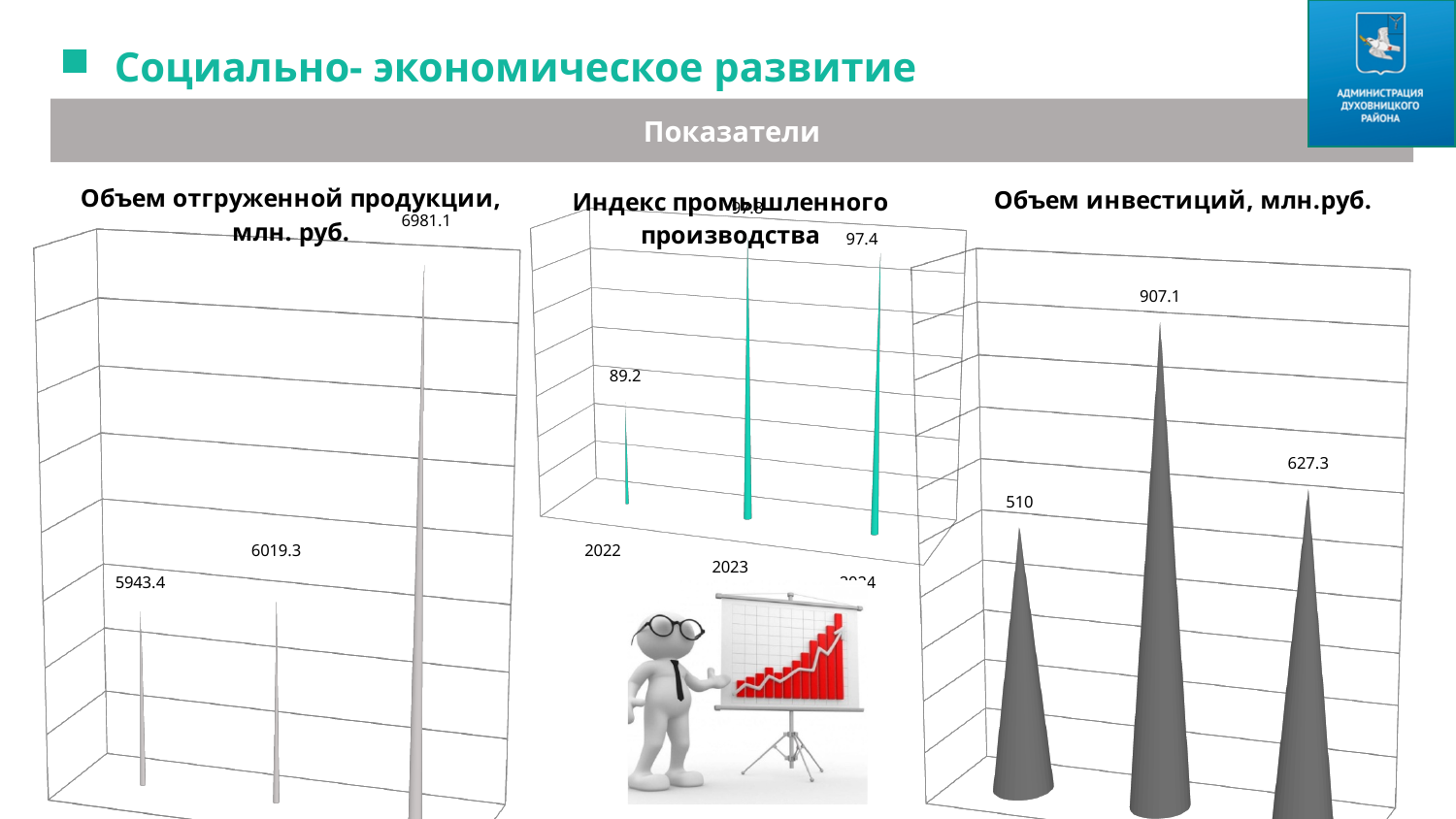
On the chart 'Объем отгруженной продукции, млн. руб.', what is the highest value shown? 6981.1 On the chart 'Индекс промышленного производства', what is the value for 2022? 89.2 On the chart 'Объем отгруженной продукции, млн. руб.', what is the difference between the highest value (6981.1) and the lowest value (5943.4)? 1037.7 On the chart 'Объем инвестиций, млн.руб.', what is the highest value shown? 907.1 On the chart 'Объем отгруженной продукции, млн. руб.', what is the lowest value shown? 5943.4 What kind of chart is 'Объем инвестиций, млн.руб.'? Bar chart On the chart 'Объем инвестиций, млн.руб.', what is the lowest value shown? 510 On the chart 'Индекс промышленного производства', what is the difference between the 2024 value and the 2022 value? 8.2 On the chart 'Индекс промышленного производства', which is larger, the value for 2022 or the value for 2024? 2024 On the chart 'Объем инвестиций, млн.руб.', what is the difference between the highest value (907.1) and the lowest value (510)? 397.1 On the chart 'Объем отгруженной продукции, млн. руб.', how many bars are plotted? 3 On the chart 'Индекс промышленного производства', what is the value for 2024? 97.4